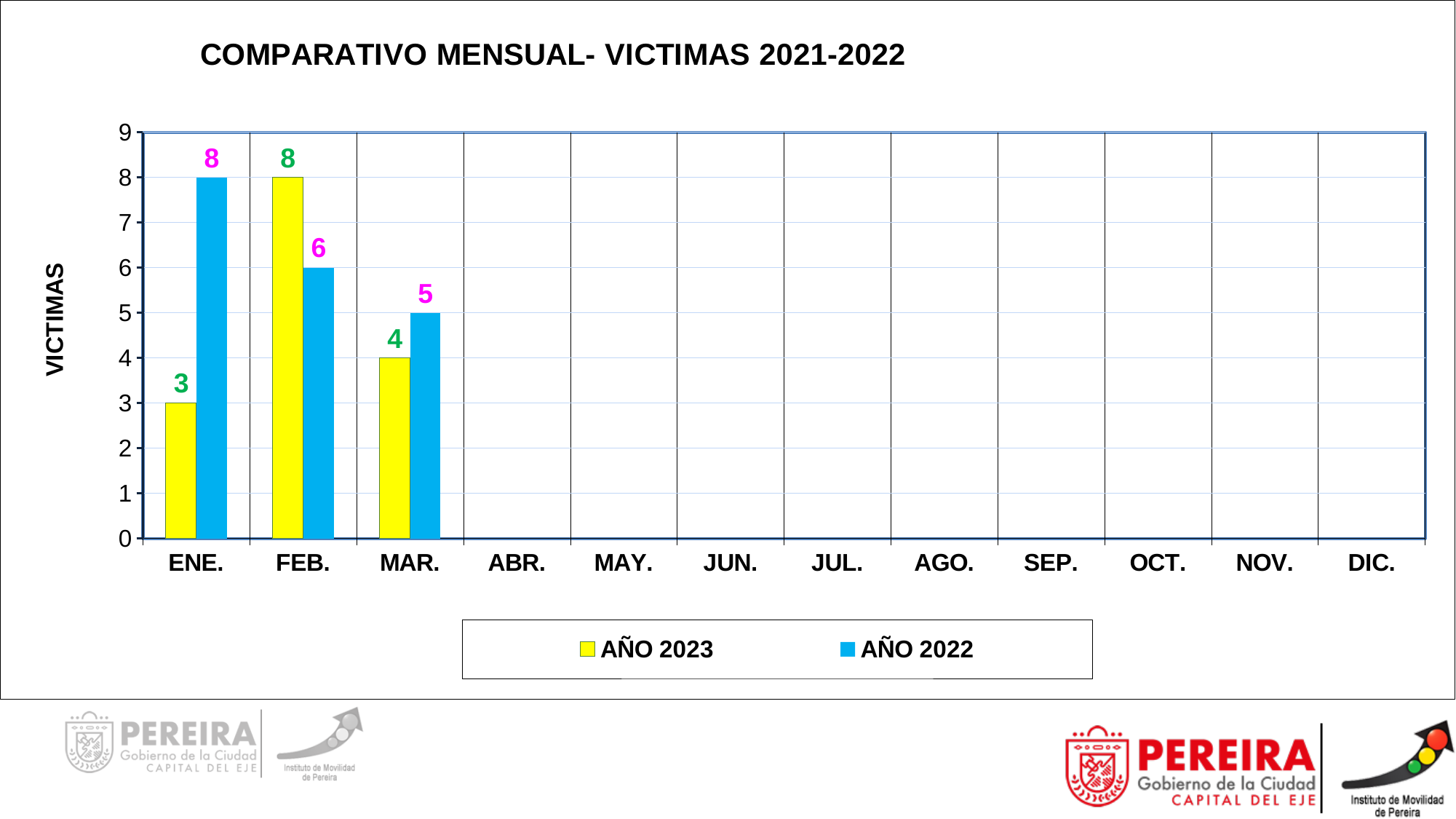
What is the title of the chart? COMPARATIVO MENSUAL- VICTIMAS 2021-2022 What is the value for AÑO 2022 in MAR.? 5 Which is larger in FEB., AÑO 2023 or AÑO 2022? AÑO 2023 How many series does the legend list? 2 What is the value for AÑO 2022 in ENE.? 8 Which month has the lowest value for AÑO 2022 among the months with data? MAR. How many months have data plotted? 3 What is the value for AÑO 2023 in ENE.? 3 What is the difference between AÑO 2022 and AÑO 2023 in ENE.? 5 What is the value for AÑO 2023 in FEB.? 8 What kind of chart is shown? Bar chart Which month has the highest value for AÑO 2023? FEB.